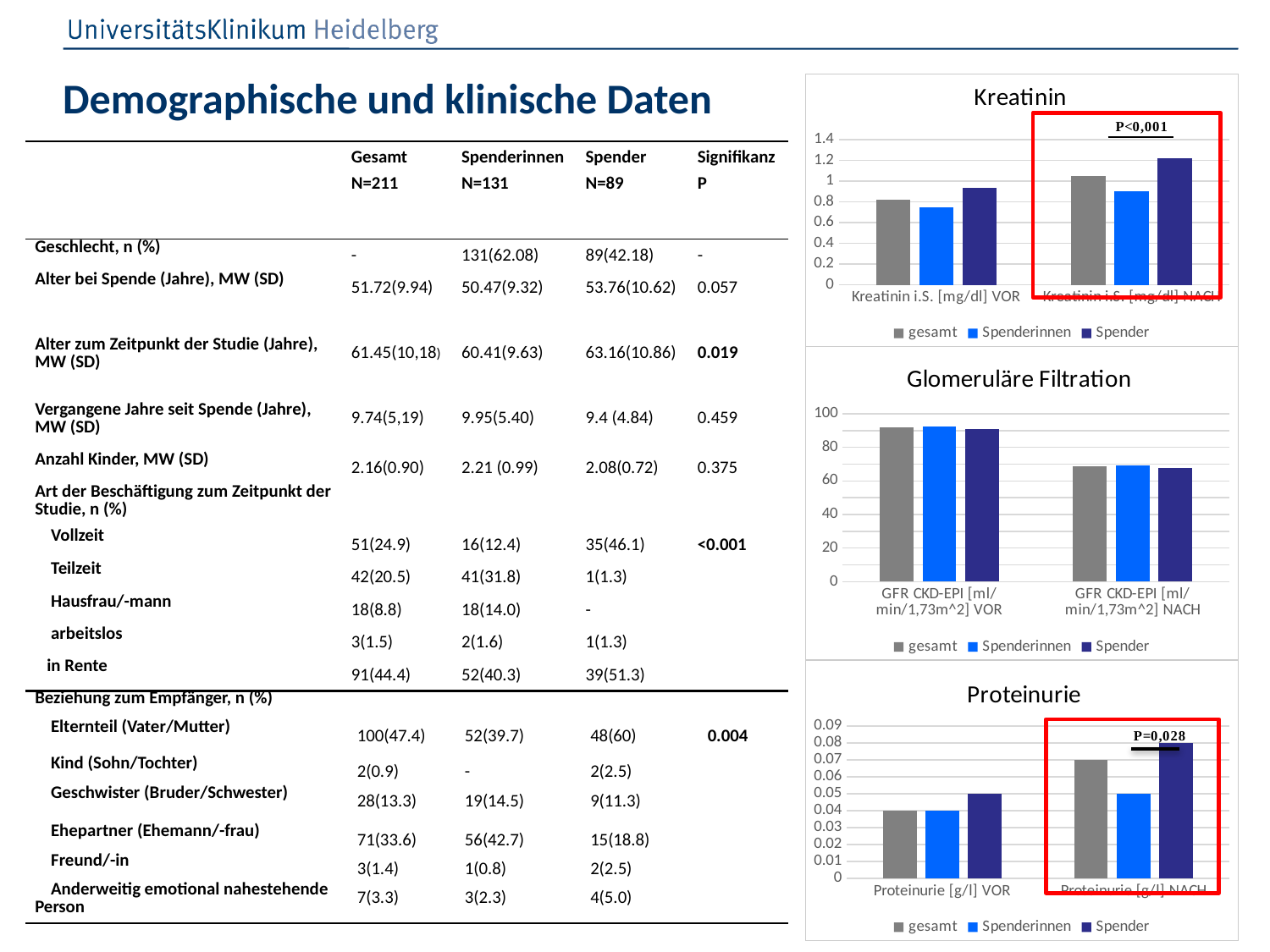
How many series does the legend of the Glomeruläre Filtration chart list? 3 In the Proteinurie chart, is the value for Spender at Proteinurie [g/l] NACH greater or less than 0.07? greater What P value is shown above the highlighted NACH group in the Proteinurie chart? P=0,028 In the Proteinurie chart, which series has the lowest bar at Proteinurie [g/l] NACH? Spenderinnen In the Glomeruläre Filtration chart, is the value for Spender at GFR CKD-EPI NACH greater or less than 80? less In the Glomeruläre Filtration chart, is the value for gesamt at GFR CKD-EPI VOR greater or less than 80? greater In the Kreatinin chart, which series has the highest bar at Kreatinin i.S. [mg/dl] NACH? Spender In the Proteinurie chart, is the gesamt bar larger at Proteinurie [g/l] VOR or at Proteinurie [g/l] NACH? NACH What kind of chart is the Kreatinin chart? bar chart In the Glomeruläre Filtration chart, do the values rise or fall from VOR to NACH? fall